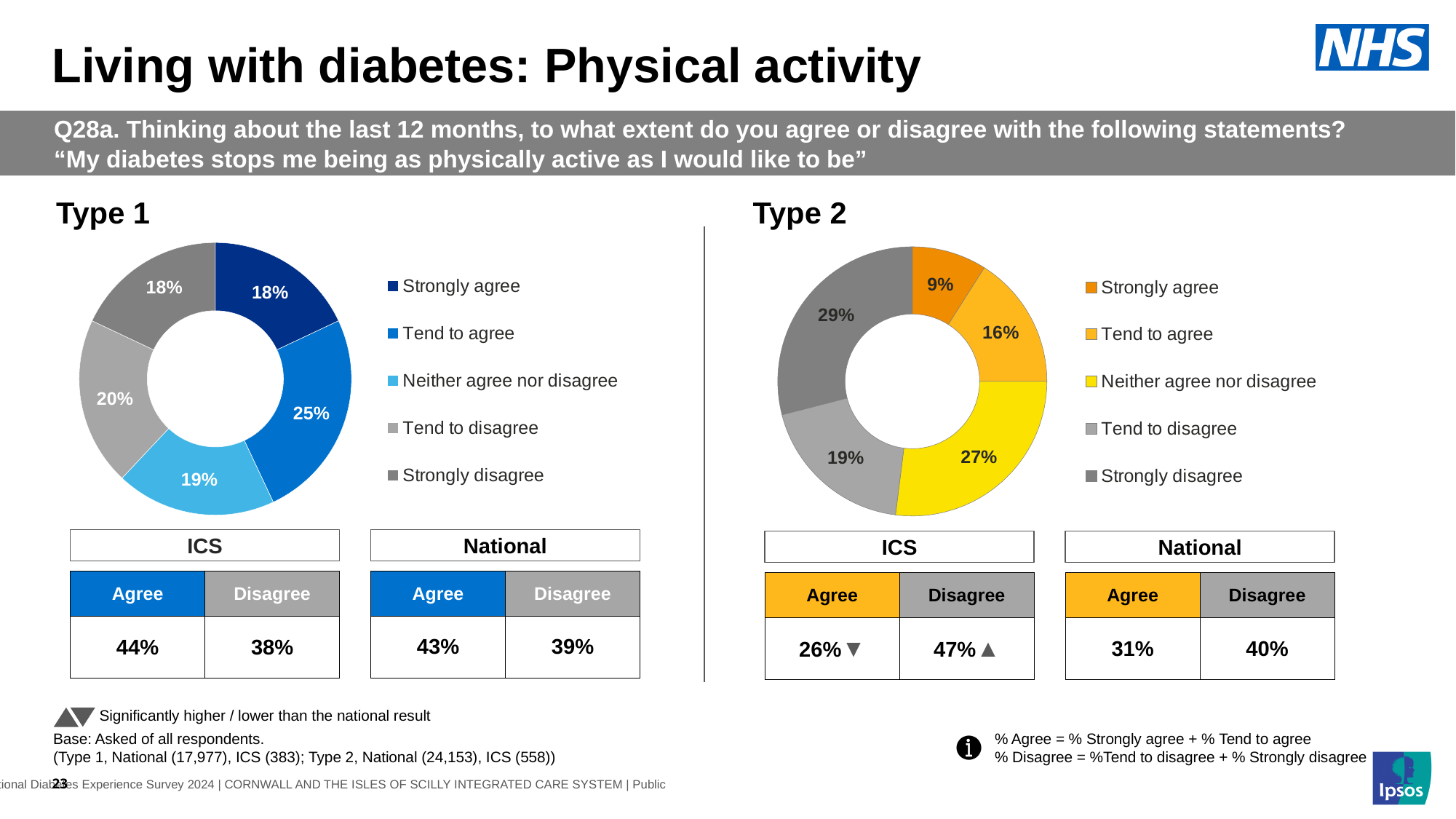
In the Type 2 chart, what percentage of respondents said 'Neither agree nor disagree'? 27% What type of chart is used to show the Type 2 results? Donut chart In the Type 2 chart, what percentage of respondents said 'Strongly disagree'? 29% In the Type 1 chart, what share of the pie is 'Strongly agree'? 18% In the Type 2 chart, which response category has the smallest share? Strongly agree In the Type 1 chart, which is larger: 'Tend to agree' or 'Tend to disagree'? Tend to agree In the Type 1 chart, what percentage of respondents said 'Tend to agree'? 25% In the Type 1 chart, which response category has the largest share? Tend to agree How many entries does the legend of the Type 2 chart list? 5 In the Type 2 chart, which is larger: 'Tend to agree' or 'Tend to disagree'? Tend to disagree How many response categories are shown in the Type 1 chart? 5 In the Type 2 chart, what is the difference between the 'Strongly disagree' share and the 'Strongly agree' share? 20 percentage points